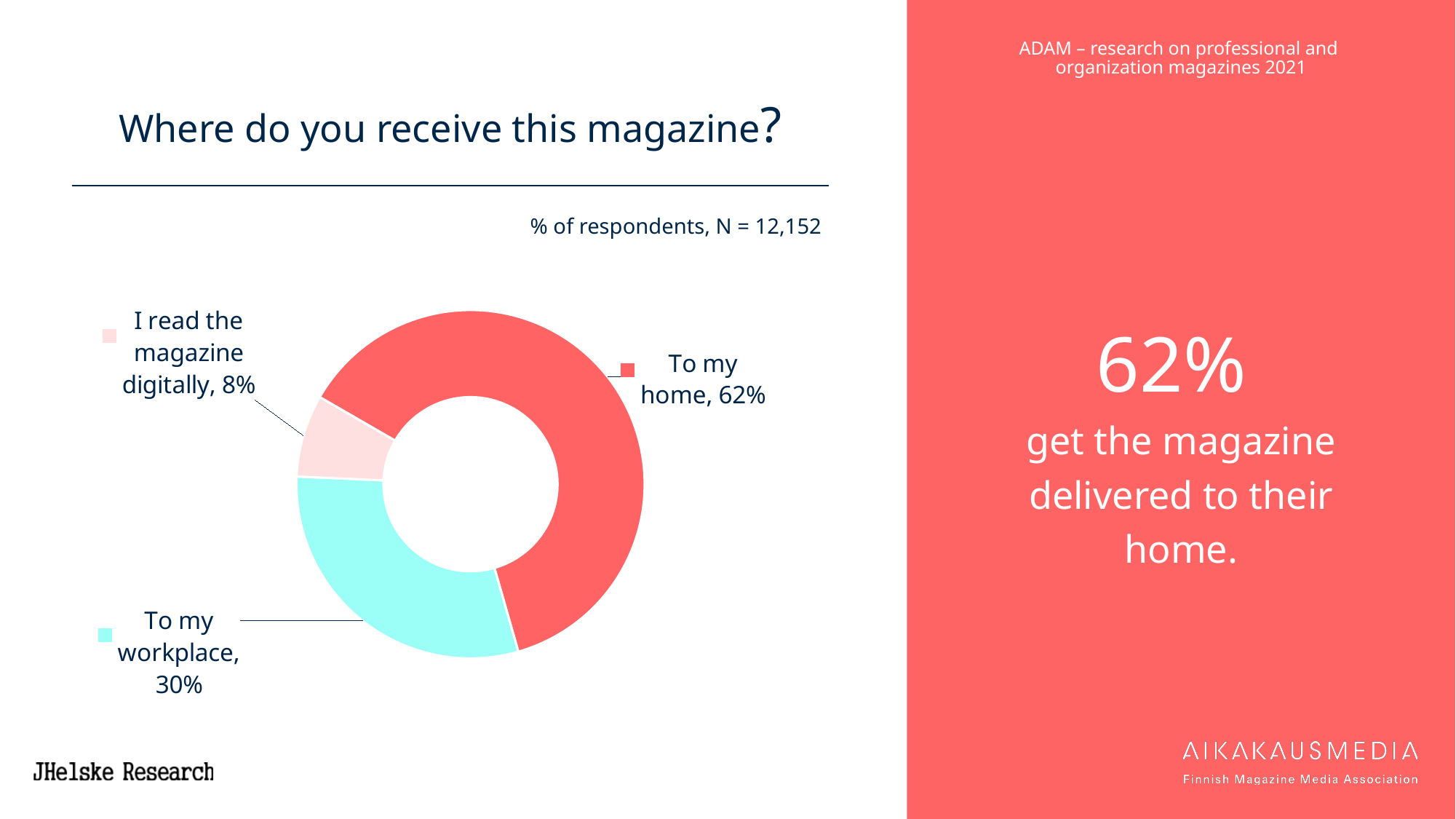
What colour is the 'To my workplace' segment of the chart? Light blue (cyan) How many categories are shown in the chart? 3 What is the difference in percentage points between 'To my home' and 'To my workplace'? 32 What percentage of respondents receive the magazine to their home? 62% Which category has the largest share of respondents? To my home What is the difference in percentage points between 'To my workplace' and 'I read the magazine digitally'? 22 Which category has the smallest share of respondents? I read the magazine digitally What kind of chart is shown on the slide? Doughnut chart What is the number of respondents (N) stated on the slide? 12,152 What percentage of respondents read the magazine digitally? 8% What percentage of respondents receive the magazine to their workplace? 30% Which is larger: the share for 'To my workplace' or for 'I read the magazine digitally'? To my workplace